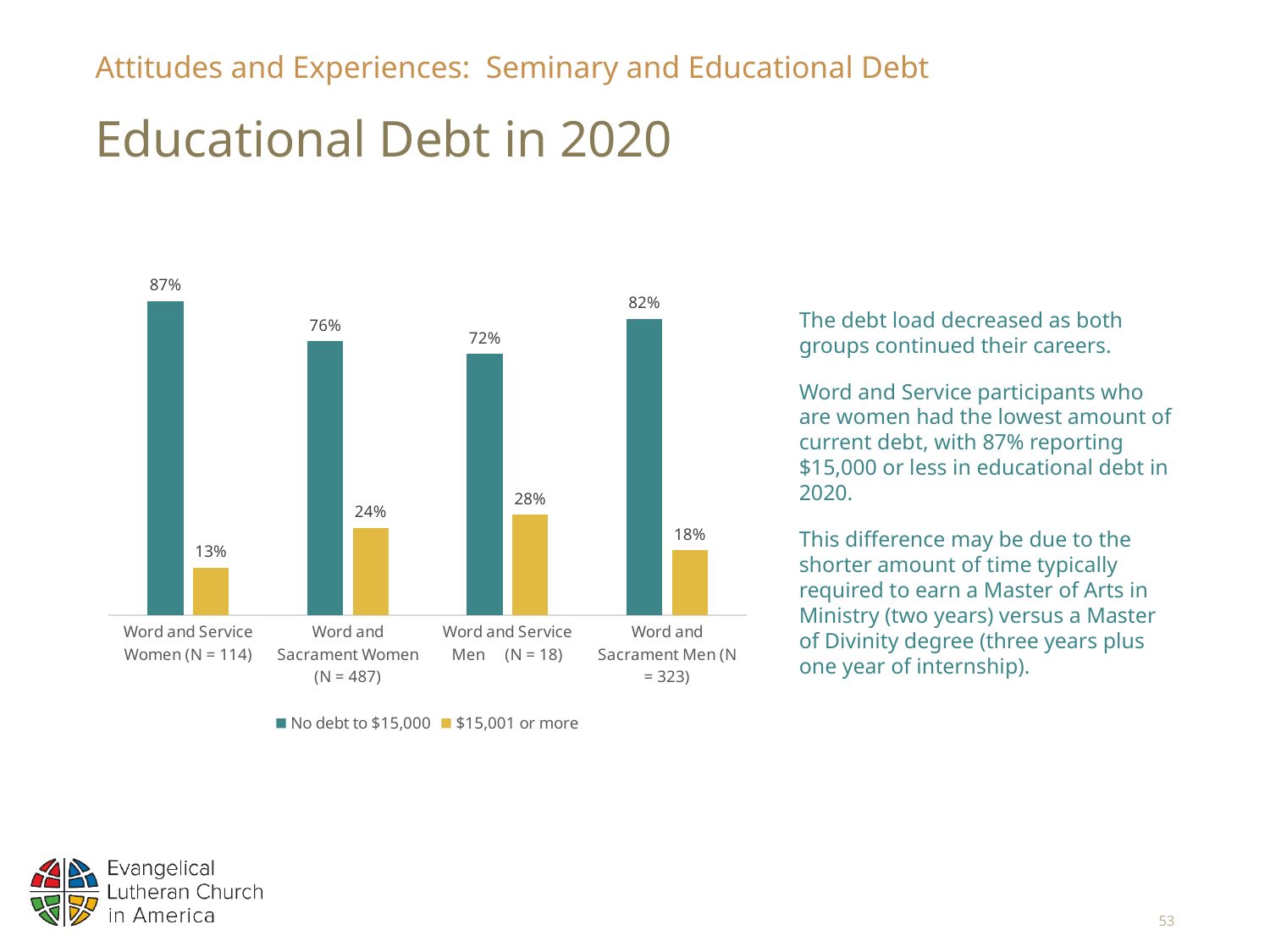
Which colour represents the $15,001 or more series in the chart? Yellow Which group has the lowest value for $15,001 or more? Word and Service Women (N = 114) What kind of chart is shown on the slide? Bar chart What percentage of Word and Service Women (N = 114) reported no debt to $15,000? 87% What percentage of Word and Sacrament Men (N = 323) reported $15,001 or more in debt? 18% How many series does the legend list? 2 What is the value for $15,001 or more for Word and Service Men (N = 18)? 28% What is the difference between the No debt to $15,000 values for Word and Service Women (N = 114) and Word and Sacrament Women (N = 487)? 11% Which group has the lowest value for No debt to $15,000? Word and Service Men (N = 18) Which group has the highest value for No debt to $15,000? Word and Service Women (N = 114) Which is larger: the $15,001 or more value for Word and Sacrament Women (N = 487) or for Word and Sacrament Men (N = 323)? Word and Sacrament Women (N = 487) How many groups are shown on the x axis of the chart? 4